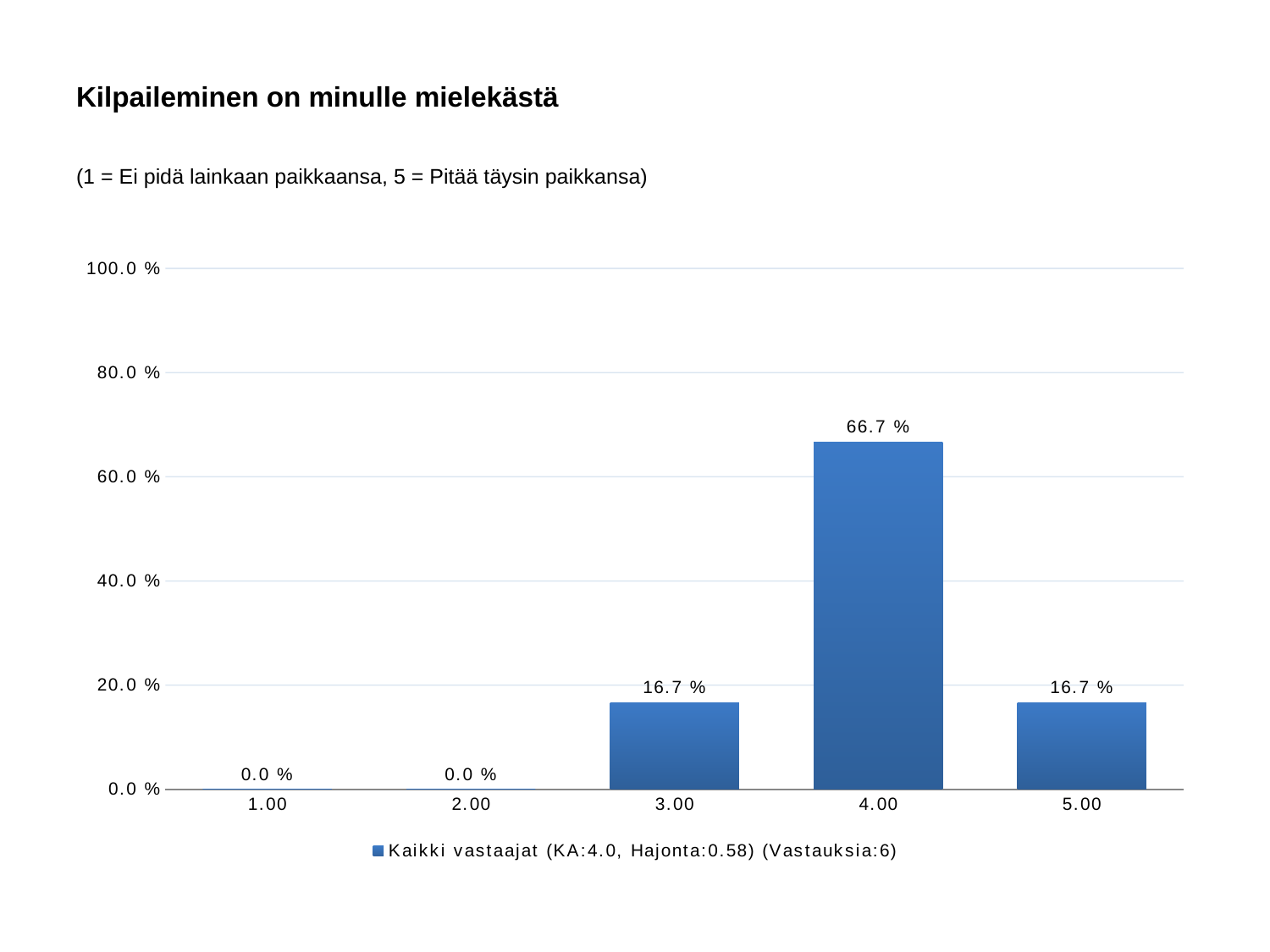
What is the value for category 3.00? 16.7 % Is the value for 4.00 greater or less than 60.0 %? greater What kind of chart is shown? bar chart What is the title of the slide? Kilpaileminen on minulle mielekästä What is the difference between the values for 4.00 and 5.00? 50.0 % What is the value for category 4.00? 66.7 % How many responses (Vastauksia) does the legend report? 6 How many series does the legend list? 1 How many categories are shown on the x axis? 5 What is the value for category 1.00? 0.0 % Which is larger, the value for 3.00 or the value for 4.00? 4.00 Which category has the highest value? 4.00